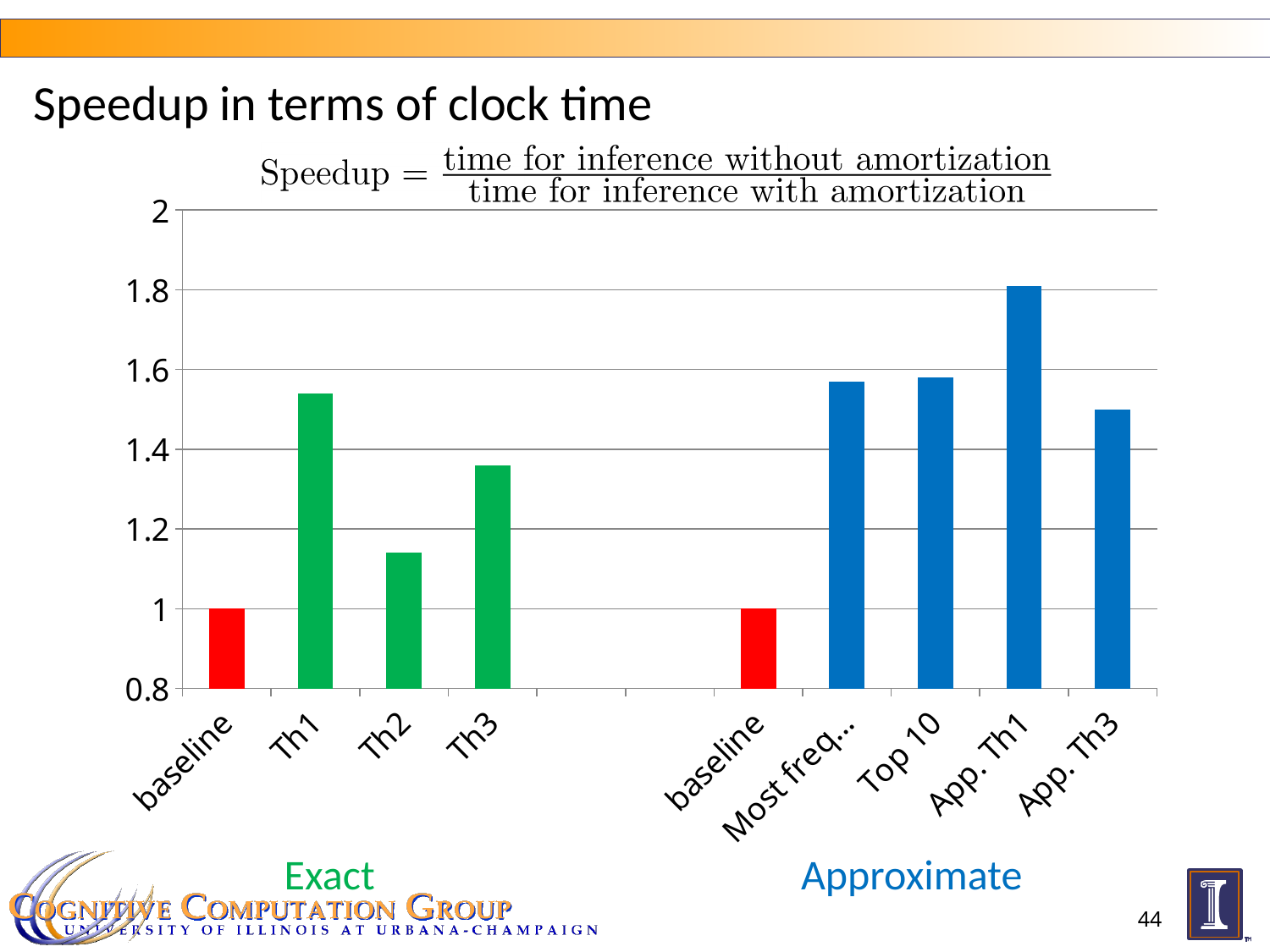
How many bars are plotted in the chart? 9 Among the green Exact bars (Th1, Th2, Th3), which has the lowest speedup? Th2 What colour are the baseline bars in the chart? red Is the speedup for Th2 greater or less than 1.2? less Is the speedup for App. Th1 greater or less than 1.6? greater Which has a larger speedup, Th1 or Th3? Th1 What kind of chart is shown on the slide? bar chart Is the speedup for Th3 greater or less than 1.4? less What is the title of the slide's chart? Speedup in terms of clock time Which category has the highest speedup? App. Th1 What is the speedup value for the baseline bars? 1